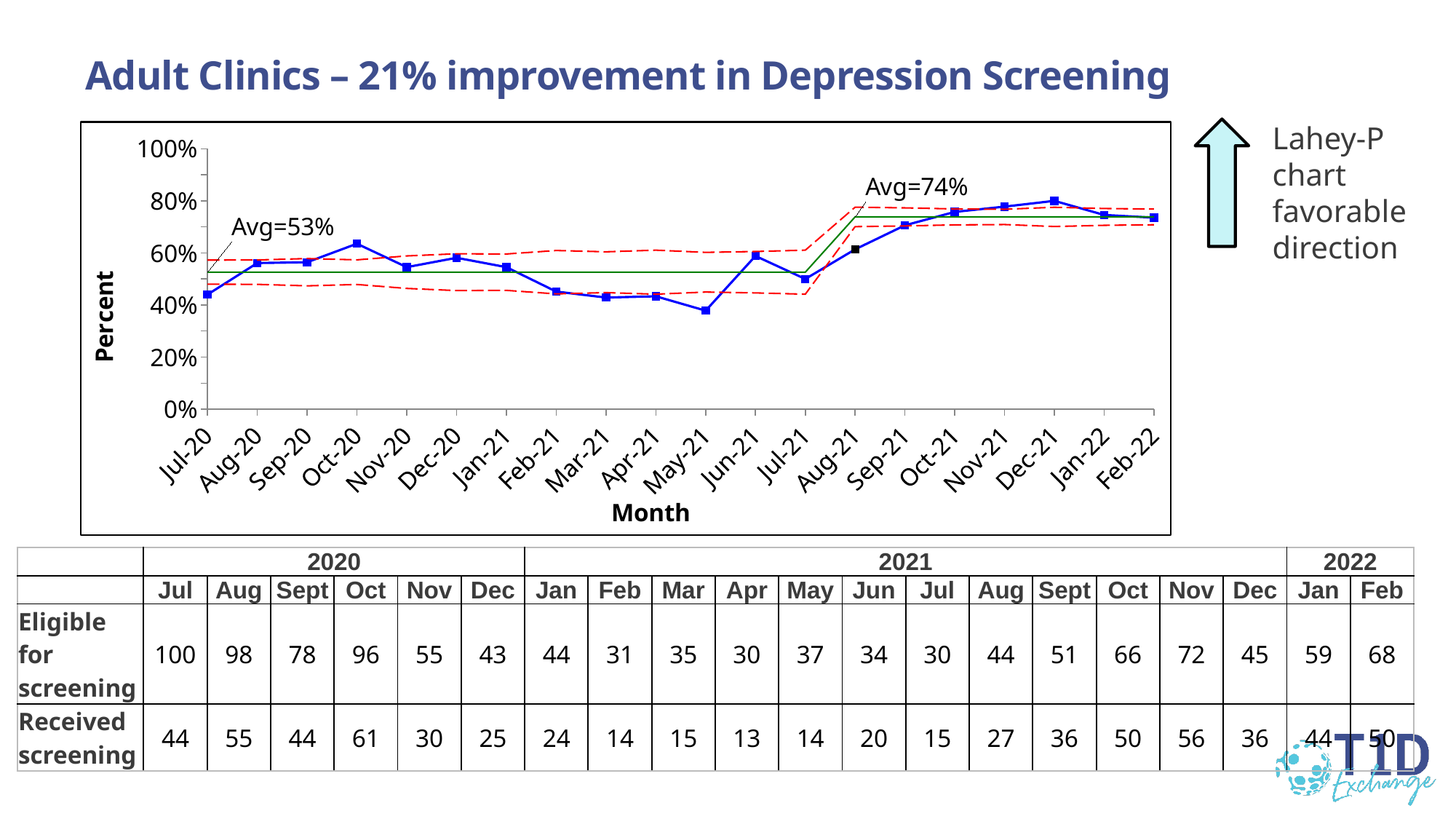
Which is larger, the value for Oct-20 or the value for Nov-20? Oct-20 What average is labeled for the first phase of the chart? Avg=53% Do the plotted values rise or fall from Jul-21 to Dec-21? rise How many monthly data points are plotted on the chart? 20 Is the value for May-21 greater or less than 60%? less Which month has the highest plotted value on the chart? Dec-21 What is the title of the y-axis? Percent Which is larger, the value for Jul-20 or the value for Aug-20? Aug-20 What kind of chart is shown on the slide? line chart Which month has the lowest plotted value on the chart? May-21 Is the value for Jul-20 greater or less than 60%? less Is the value for Dec-21 greater or less than 60%? greater